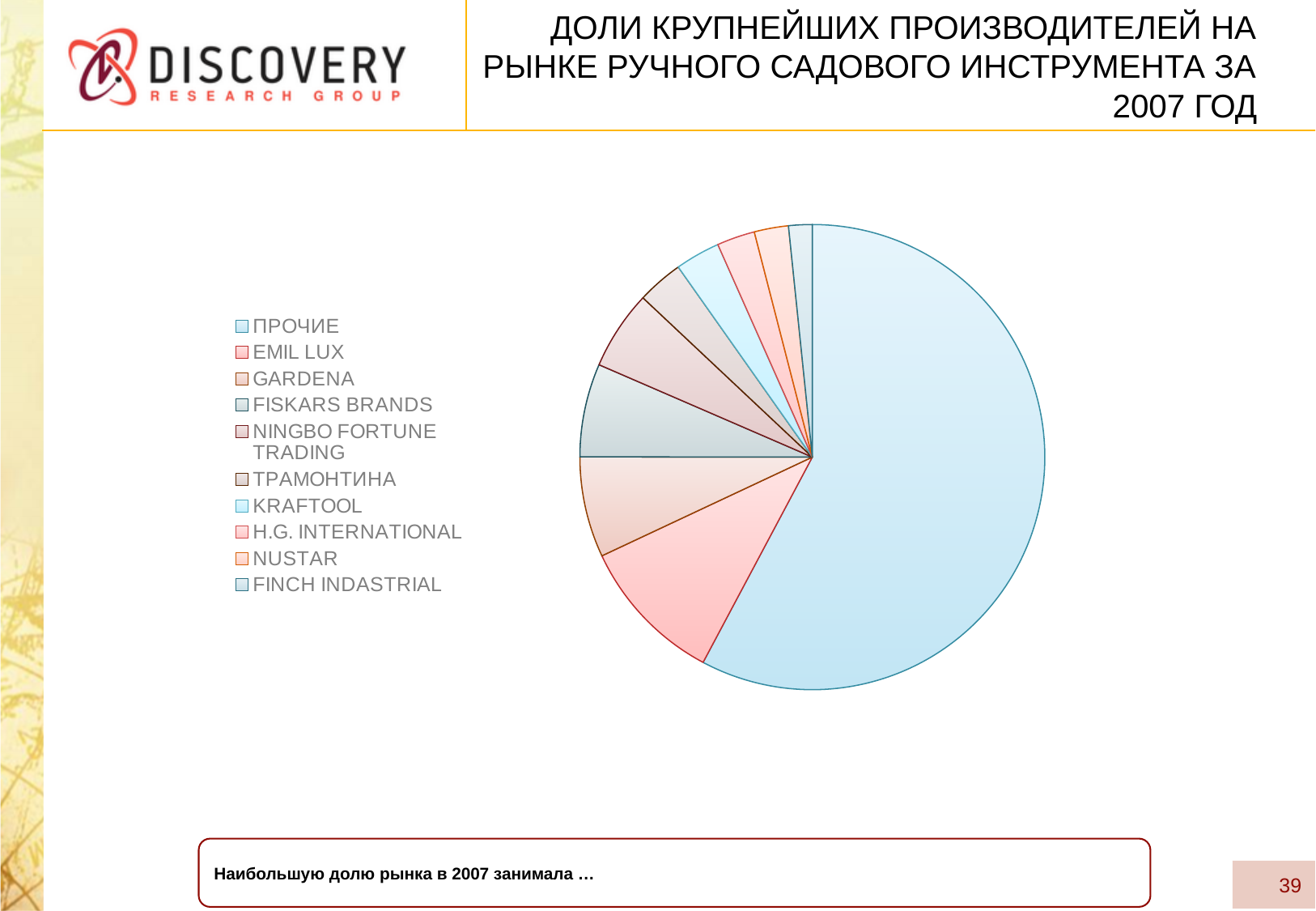
Which category is listed first in the legend of the pie chart? ПРОЧИЕ Which is larger in the pie chart, the slice for ПРОЧИЕ or the slice for EMIL LUX? ПРОЧИЕ Which year does the chart title say the market shares refer to? 2007 Which is larger in the pie chart, the slice for GARDENA or the slice for NUSTAR? GARDENA What kind of chart is shown on the slide? pie chart How many categories does the legend of the pie chart list? 10 Which is larger in the pie chart, the slice for EMIL LUX or the slice for GARDENA? EMIL LUX Does the slice for ПРОЧИЕ take up more or less than half of the pie chart? more Which category has the largest slice of the pie chart? ПРОЧИЕ